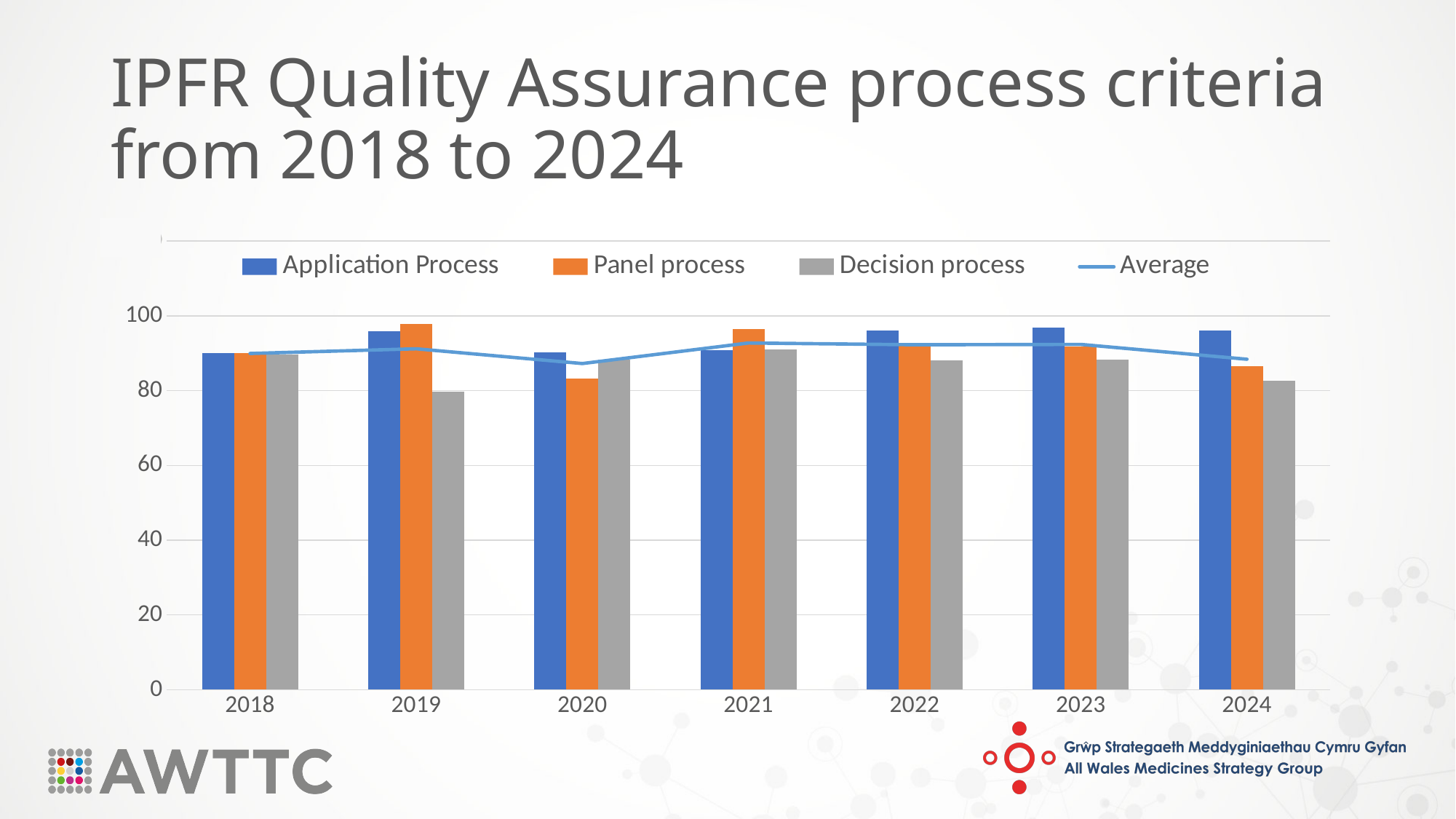
In 2019, which series has the lowest value? Decision process Is the value for Panel process in 2020 greater or less than 90? less What colour are the Panel process bars? orange Is the value for Decision process in 2024 greater or less than 90? less Which series is drawn as a line rather than bars? Average In 2024, which is larger: Application Process or Decision process? Application Process Is the value for Application Process in 2019 greater or less than 90? greater In 2019, which is larger: Panel process or Decision process? Panel process How many series does the legend list? 4 How many years are shown along the x axis? 7 What kind of chart is shown on the slide? combination bar and line chart In 2021, which series has the highest value? Panel process